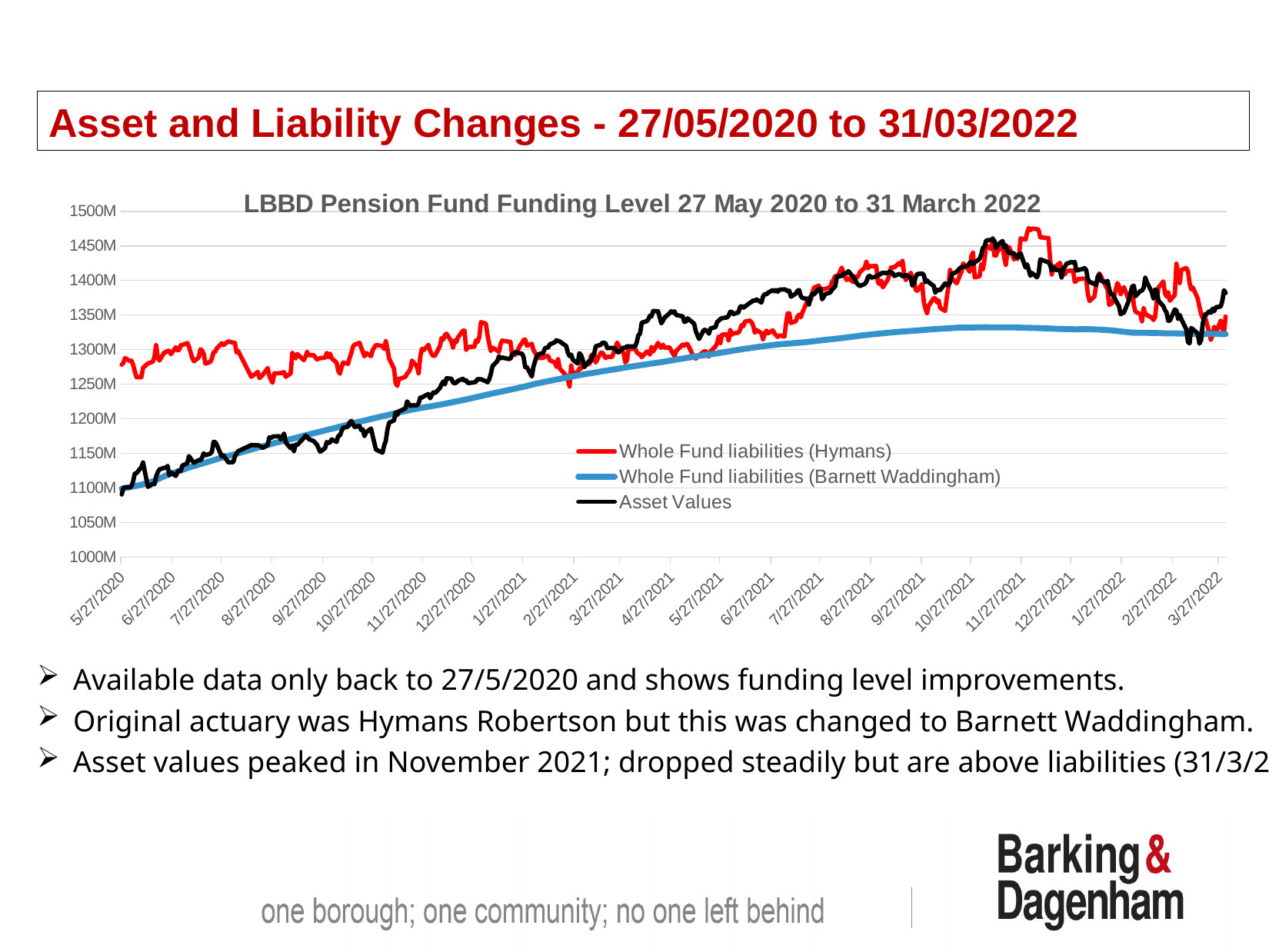
How many series does the chart legend list? 3 What is the title of the chart? LBBD Pension Fund Funding Level 27 May 2020 to 31 March 2022 Is the Asset Values line at 11/27/2021 greater or less than 1400M? greater Is the Whole Fund liabilities (Hymans) line at 5/27/2020 greater or less than 1250M? greater Which colour is used for the Asset Values series? black Is the Whole Fund liabilities (Barnett Waddingham) line at 3/27/2022 greater or less than 1350M? less At 11/27/2021, which is larger: Asset Values or Whole Fund liabilities (Barnett Waddingham)? Asset Values How many date labels are shown on the x axis? 23 Do the Asset Values generally rise or fall from 5/27/2020 to 3/27/2022? rise What kind of chart is shown on the slide? line chart At 5/27/2020, which is larger: Whole Fund liabilities (Hymans) or Asset Values? Whole Fund liabilities (Hymans)